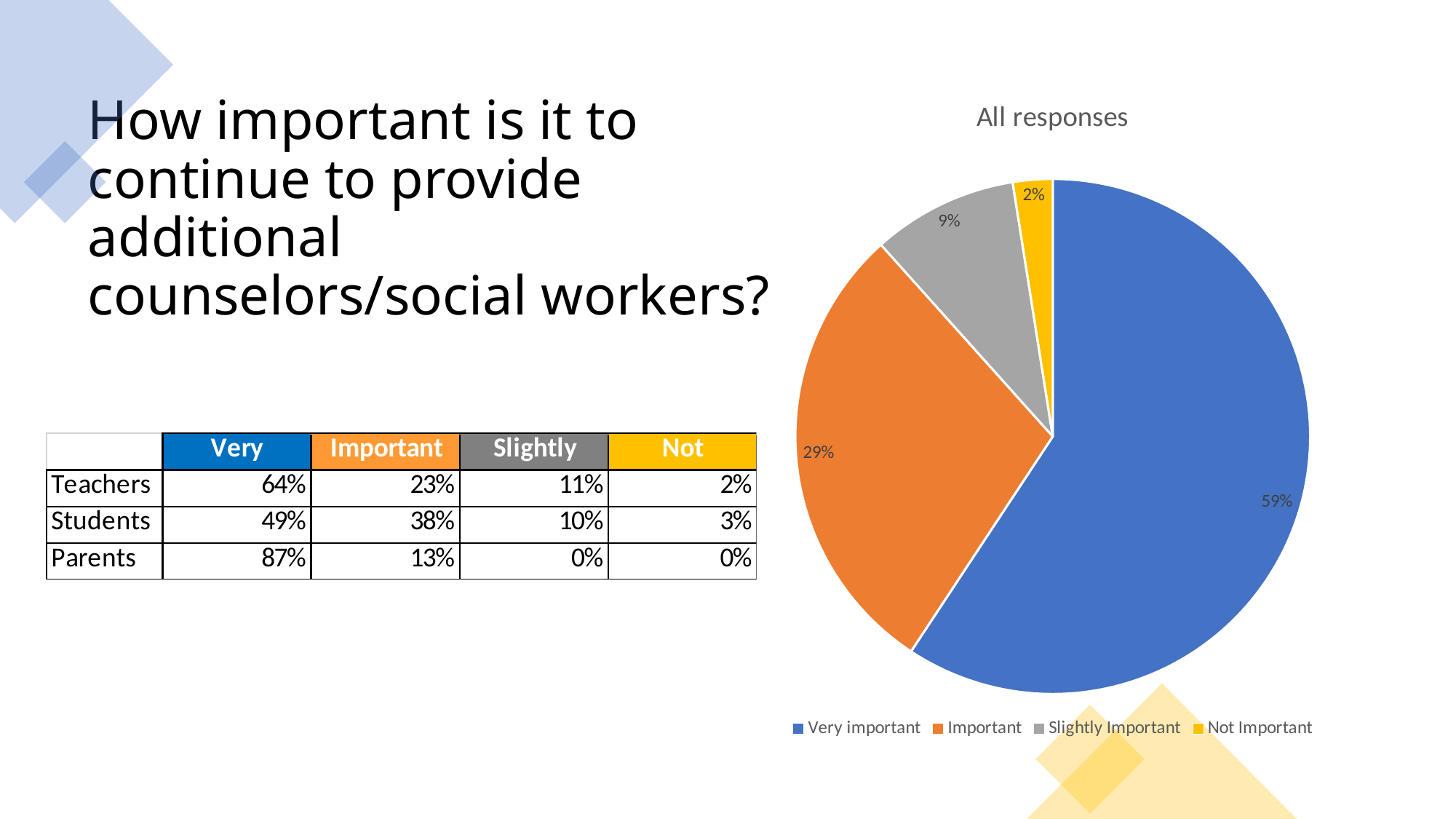
Which category has the smallest slice of the pie? Not Important How many entries does the legend list? 4 What is the difference in percentage points between the Very important and Important slices? 30 What kind of chart is shown on the slide? pie chart How many slices does the pie chart have? 4 Which slice is larger, Important or Slightly Important? Important What share of the pie is labelled Not Important? 2% What share of the pie is labelled Slightly Important? 9% What is the title of the chart? All responses Which category has the largest slice of the pie? Very important What share of the pie is labelled Very important? 59%